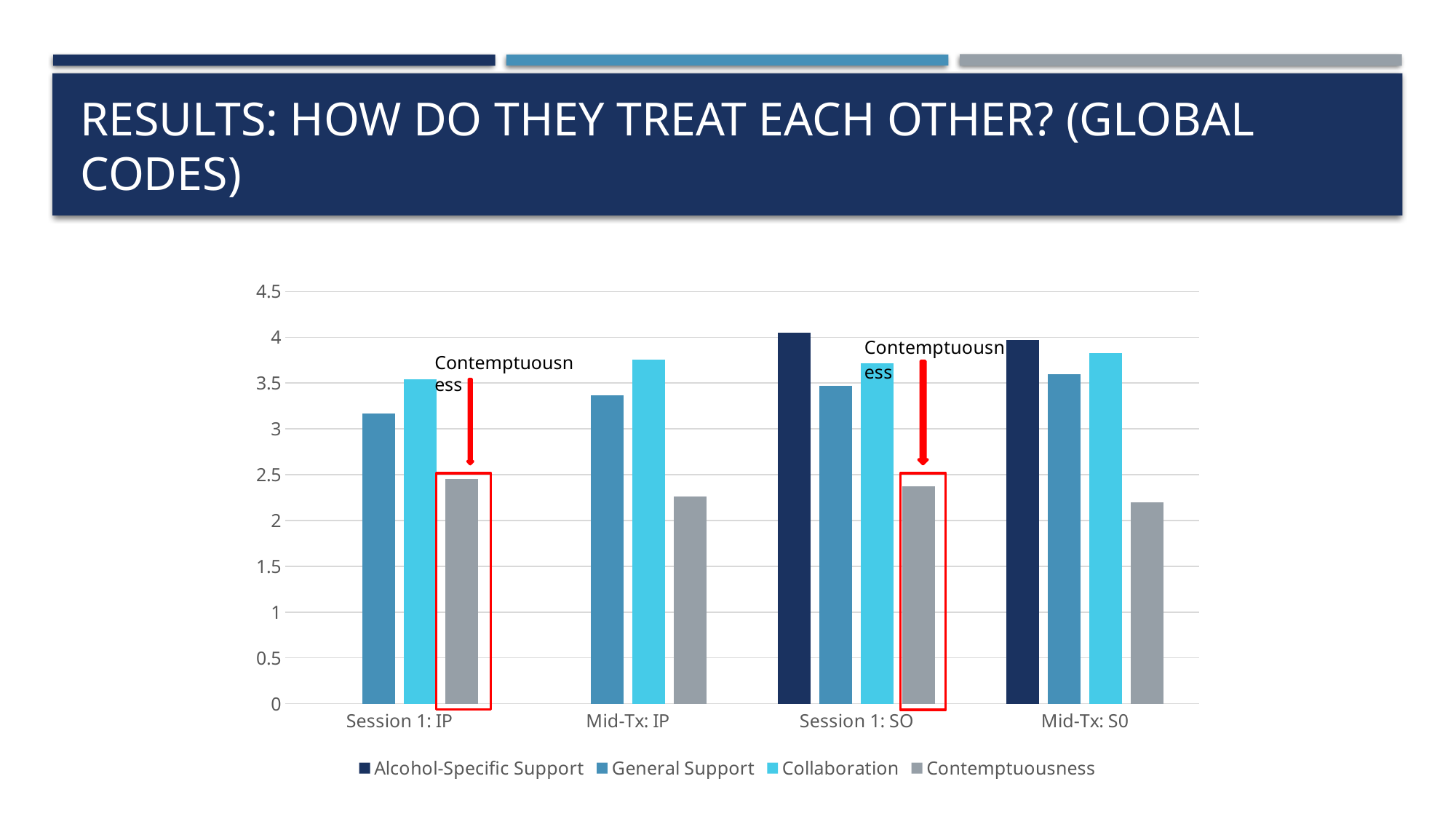
Which series is highlighted with red boxes and arrows on the chart? Contemptuousness Is the value for Alcohol-Specific Support in Session 1: SO greater or less than 3.5? greater Is the value for Collaboration in Mid-Tx: S0 greater or less than 3.5? greater Which series has the lowest value in Mid-Tx: S0? Contemptuousness How many series does the legend list? 4 Which series has the highest value in Session 1: SO? Alcohol-Specific Support What kind of chart is shown on the slide? bar chart In Mid-Tx: IP, which is larger, Collaboration or General Support? Collaboration Is the value for Contemptuousness in Session 1: IP greater or less than 3? less How many categories are shown on the x axis? 4 Does the Contemptuousness value rise or fall from Session 1: IP to Mid-Tx: IP? fall Which series is shown in the darkest navy colour in the legend? Alcohol-Specific Support